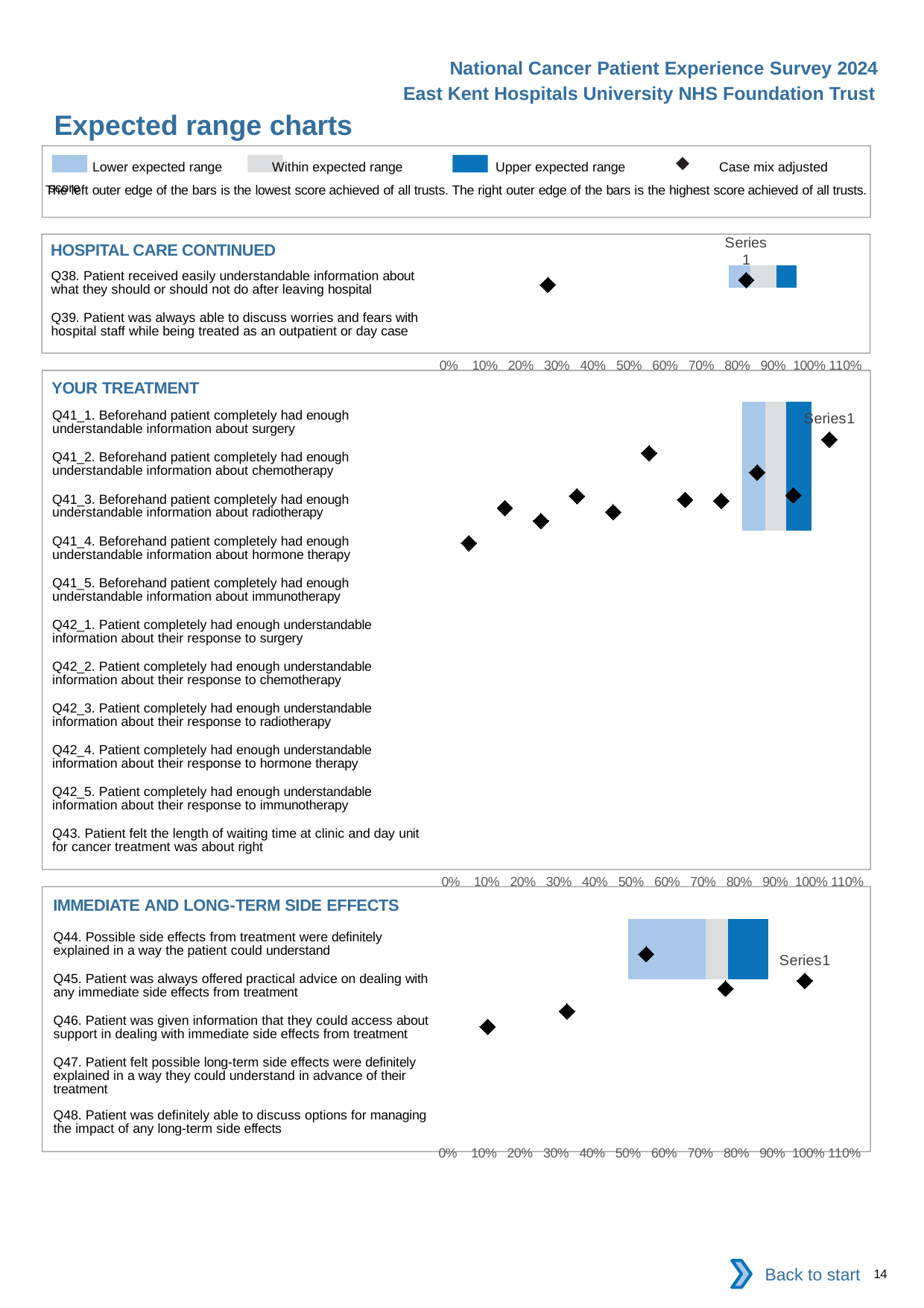
In the YOUR TREATMENT chart, how many questions (categories) are listed? 11 What is the title of the top chart on the slide? HOSPITAL CARE CONTINUED How many entries does the legend at the top of the slide list? 4 What kind of chart is used in the YOUR TREATMENT section? bar chart How many charts are shown on the slide? 3 Which of the three charts on the slide has the most categories? YOUR TREATMENT In the HOSPITAL CARE CONTINUED chart, how many questions (categories) are listed? 2 Which legend entry is represented by a diamond marker? Case mix adjusted score